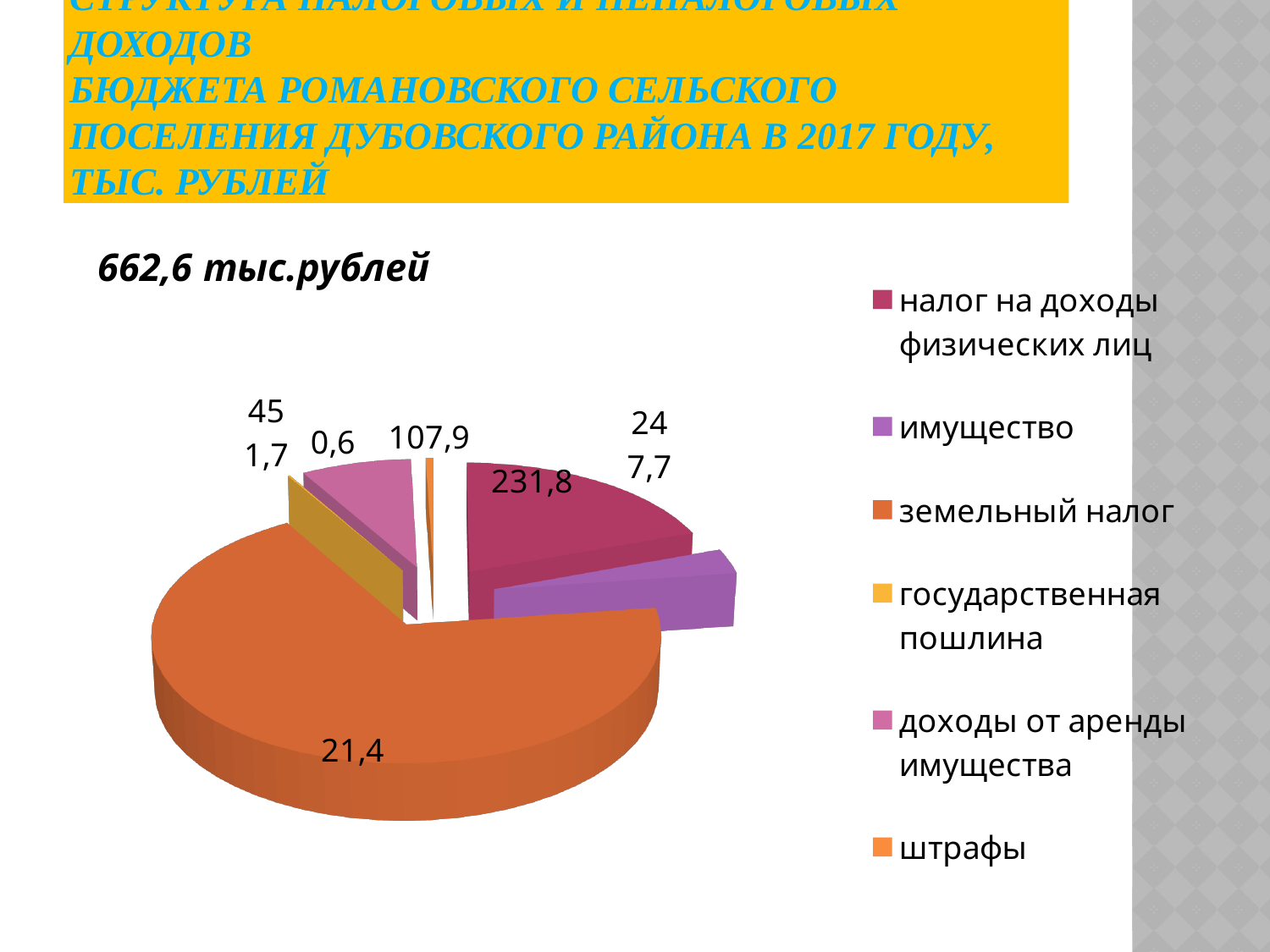
Which slice is larger: земельный налог or налог на доходы физических лиц? земельный налог What kind of chart is shown on the slide? pie chart Which year does the chart title say the budget revenue structure refers to? 2017 How many categories does the legend of the pie chart list? 6 Which category has the largest slice of the pie chart? земельный налог Which slice is larger: налог на доходы физических лиц or государственная пошлина? налог на доходы физических лиц Which slice is larger: земельный налог or имущество? земельный налог What total amount is printed above the pie chart? 662,6 тыс.рублей